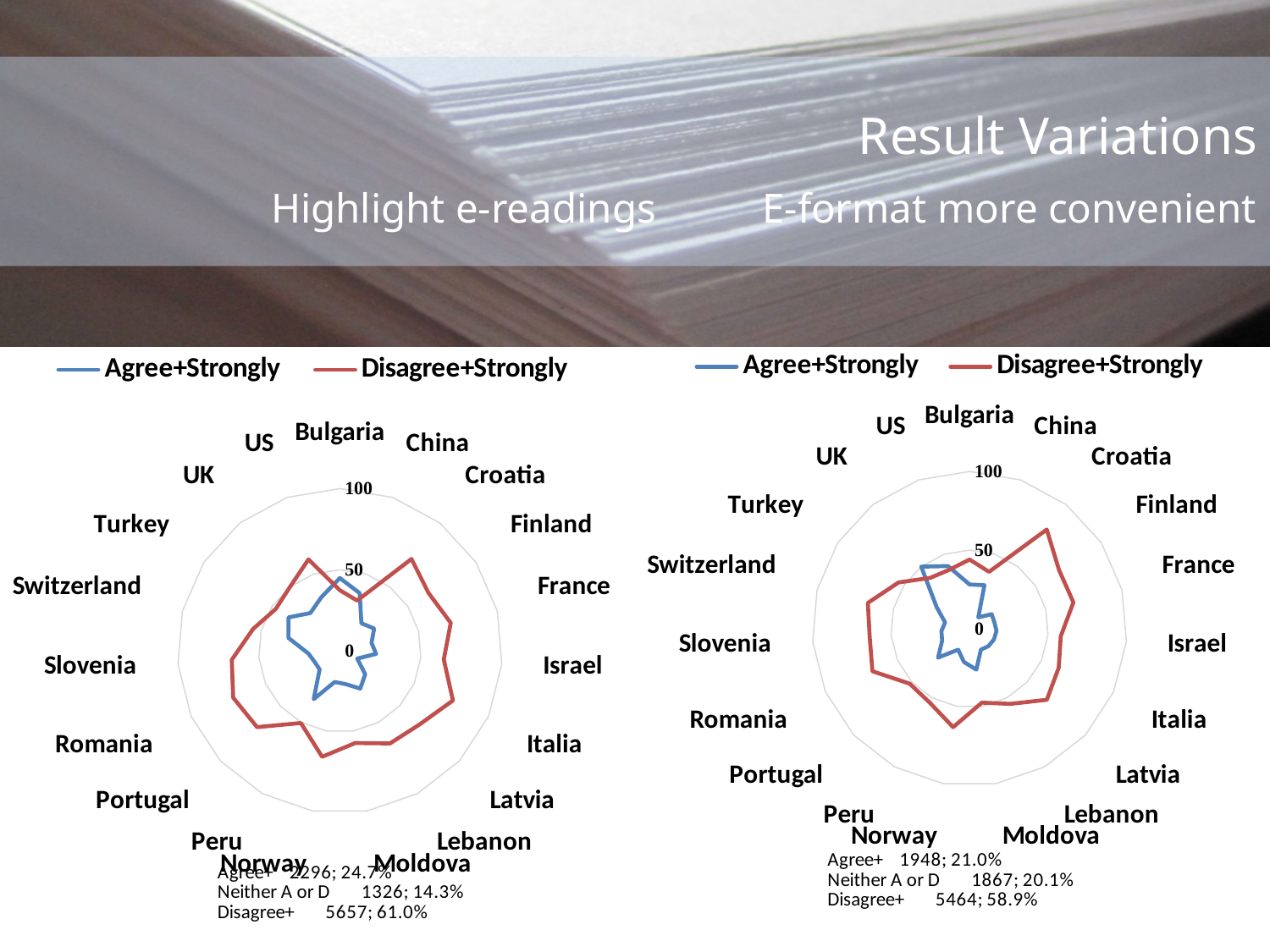
On the 'E-format more convenient' chart on the right, which is larger for Finland, Agree+Strongly or Disagree+Strongly? Disagree+Strongly What is the highest value shown on the axis scale of the 'Highlight e-readings' chart on the left? 100 How many countries are plotted on the 'Highlight e-readings' chart on the left? 19 How many series does the legend of the 'E-format more convenient' chart on the right list? 2 On the 'E-format more convenient' chart on the right, is the Agree+Strongly value for Israel greater or less than 50? less On the 'E-format more convenient' chart on the right, what are the two legend entries? Agree+Strongly and Disagree+Strongly On the 'Highlight e-readings' chart on the left, which colour is the Disagree+Strongly series? Red What kind of chart is the 'Highlight e-readings' chart on the left? Radar chart On the 'Highlight e-readings' chart on the left, is the Disagree+Strongly value for Finland greater or less than 50? greater On the 'Highlight e-readings' chart on the left, is the Agree+Strongly value for Israel greater or less than 50? less On the 'Highlight e-readings' chart on the left, which is larger for Israel, Agree+Strongly or Disagree+Strongly? Disagree+Strongly